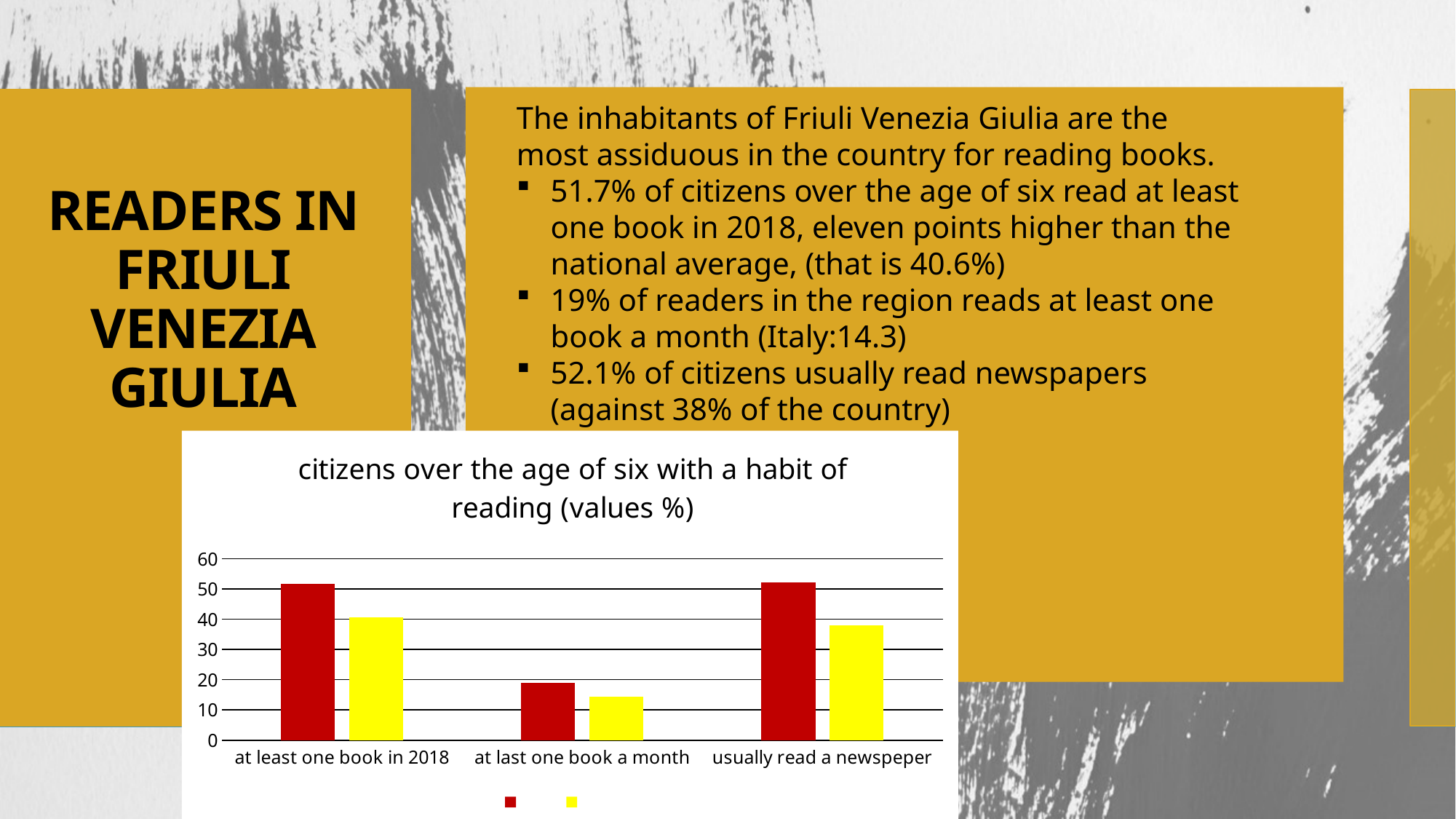
For 'at least one book in 2018', which bar is larger, the red one or the yellow one? red For 'usually read a newspeper', which bar is larger, the red one or the yellow one? red What is the title of the chart? citizens over the age of six with a habit of reading (values %) How many series does the chart's legend list? 2 Which category has the lowest red bar? at last one book a month How many categories are shown on the x axis of the chart? 3 Is the yellow bar for 'at last one book a month' greater or less than 20? less What two colours are used for the bars in the chart? red and yellow What kind of chart is shown on the slide? bar chart Is the red bar for 'at least one book in 2018' greater or less than 40? greater Which category has the lowest yellow bar? at last one book a month Is the yellow bar for 'usually read a newspeper' greater or less than 30? greater